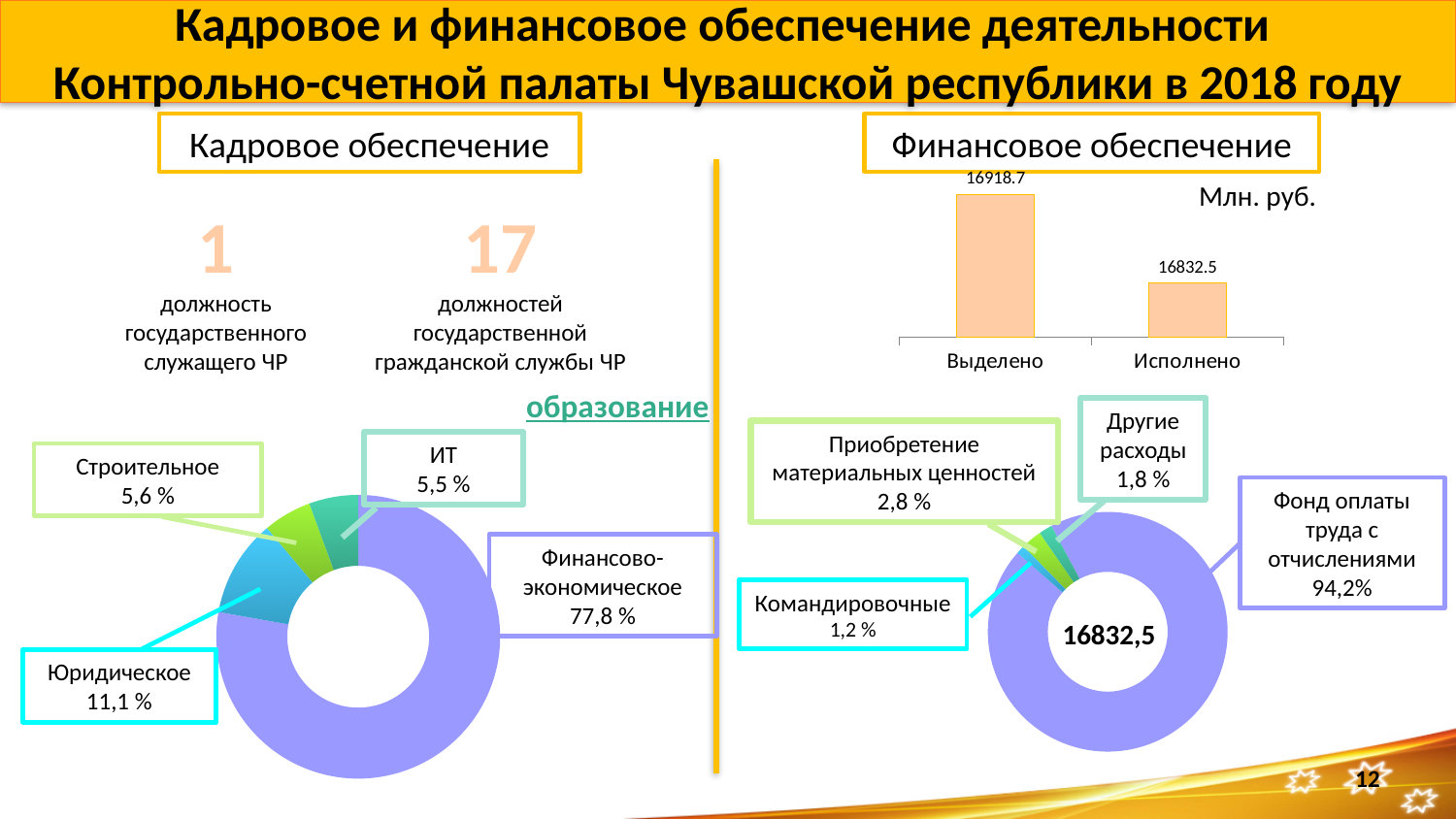
On the left donut chart (образование), which category has the smallest share? ИТ On the bar chart under "Финансовое обеспечение", what is the value for "Выделено"? 16918.7 On the left donut chart (образование), what share is "Финансово-экономическое"? 77,8 % On the right donut chart (expenses), which category has the smallest share? Командировочные How many bars are on the bar chart under "Финансовое обеспечение"? 2 What type of chart is shown at the top right under "Финансовое обеспечение"? Bar chart On the bar chart under "Финансовое обеспечение", which category has the higher value? Выделено On the bar chart under "Финансовое обеспечение", what is the difference between "Выделено" and "Исполнено"? 86.2 On the right donut chart (expenses), what share is "Фонд оплаты труда с отчислениями"? 94,2% On the bar chart under "Финансовое обеспечение", what is the value for "Исполнено"? 16832.5 On the left donut chart (образование), what share is "Юридическое"? 11,1 % How many categories are shown on the left donut chart (образование)? 4